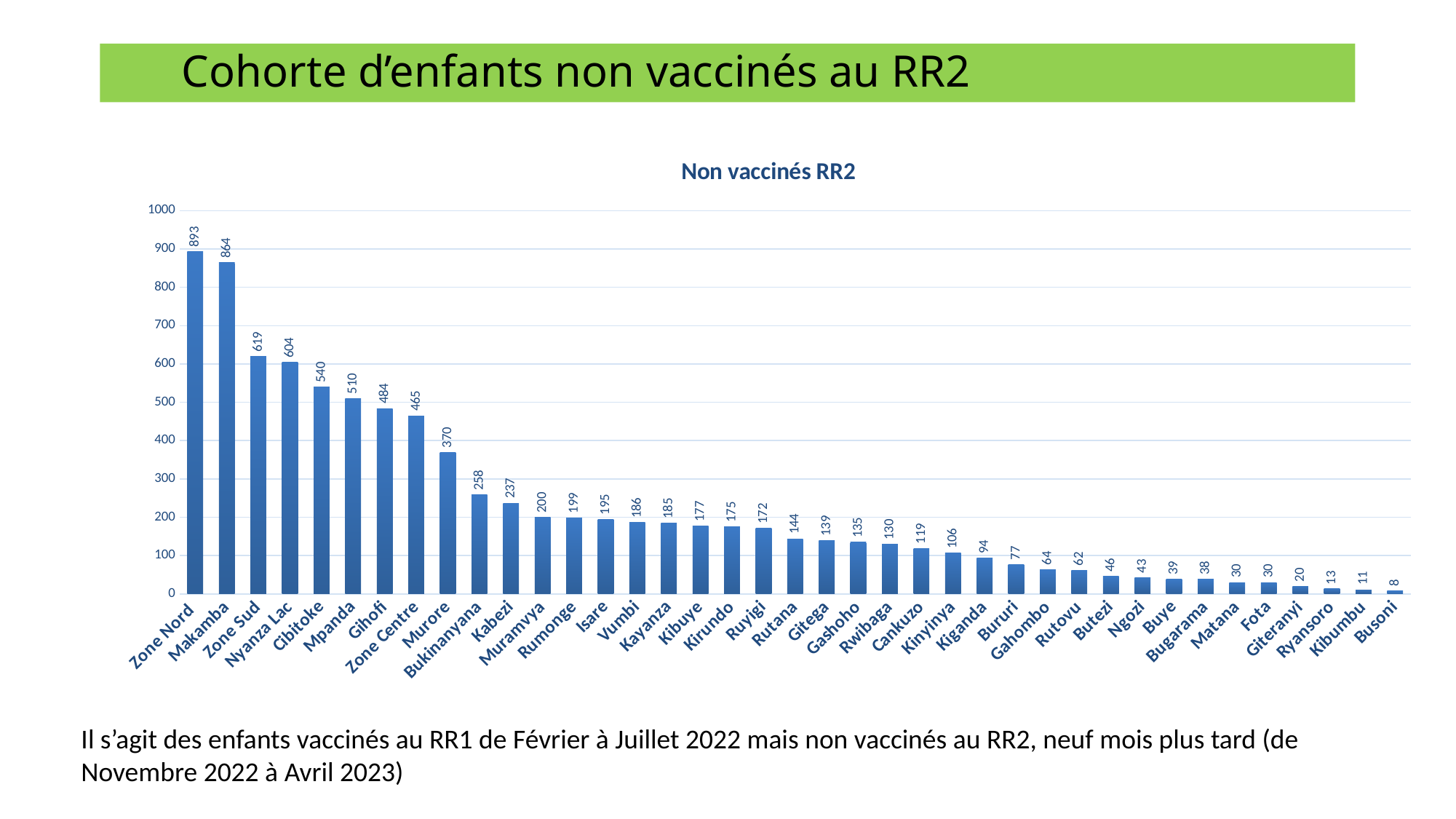
Which category has the lowest value? Busoni What is the difference between the values for Zone Nord and Makamba? 29 What is the value for Cibitoke? 540 Which is larger, the value for Murore or the value for Bukinanyana? Murore What is the value for Gahombo? 64 Which category has the highest value? Zone Nord What kind of chart is shown on the slide? Bar chart Do the values rise or fall from left to right along the x axis? Fall What is the title of the chart? Non vaccinés RR2 What is the value for Makamba? 864 What is the value for Kirundo? 175 How many categories are shown on the x axis? 39